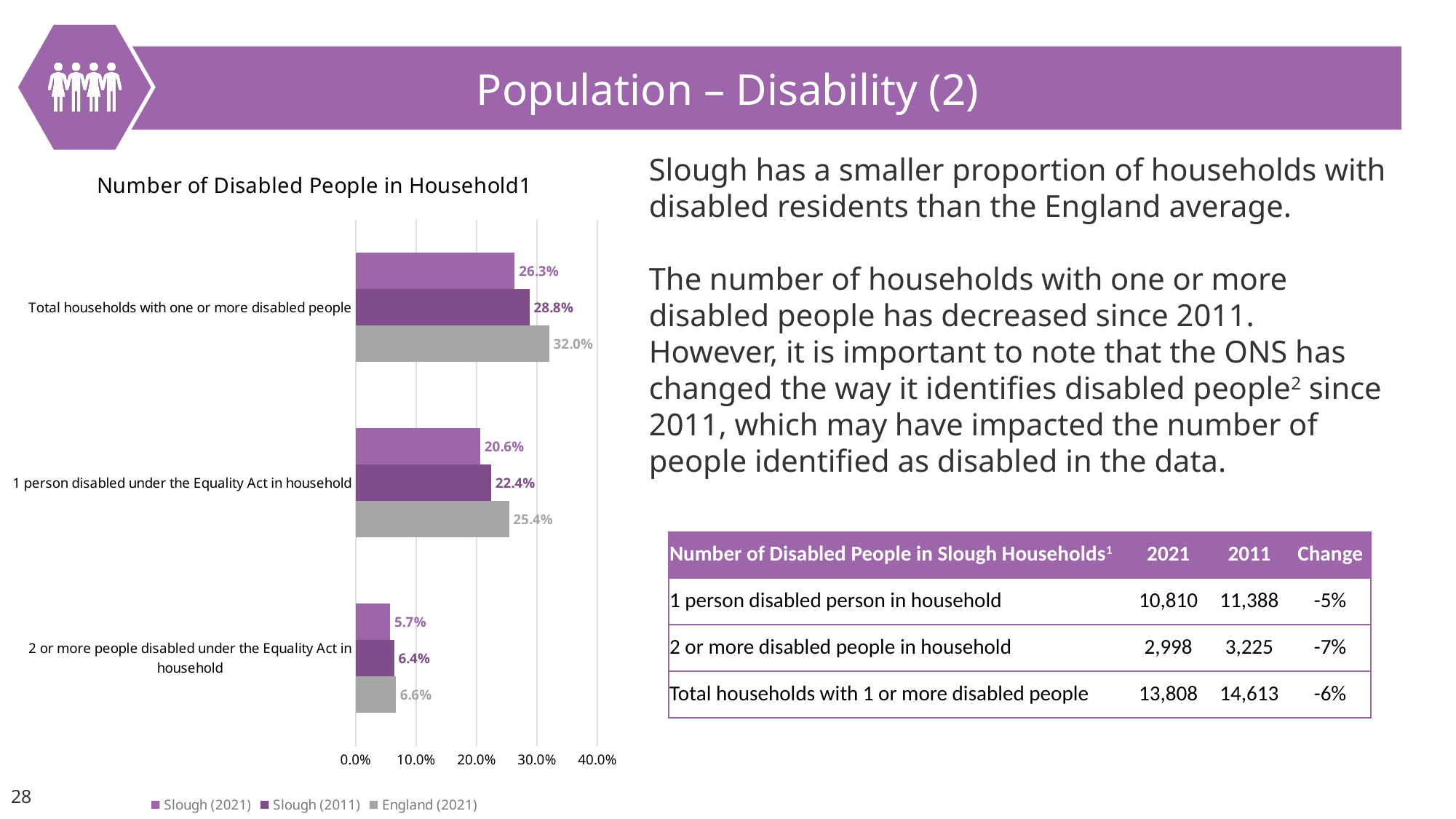
Which category has the lowest Slough (2021) value? 2 or more people disabled under the Equality Act in household What type of chart is shown on the slide? Bar chart What is the Slough (2021) value for 'Total households with one or more disabled people'? 26.3% Which is larger for '1 person disabled under the Equality Act in household': Slough (2021) or Slough (2011)? Slough (2011) Is the England (2021) value for 'Total households with one or more disabled people' greater or less than 30.0%? greater Which series has the highest value for 'Total households with one or more disabled people'? England (2021) How many series does the chart legend list? 3 What is the difference between the Slough (2011) and Slough (2021) values for '1 person disabled under the Equality Act in household'? 1.8% What is the difference between the England (2021) and Slough (2021) values for 'Total households with one or more disabled people'? 5.7% How many categories are shown on the chart? 3 What is the Slough (2011) value for '2 or more people disabled under the Equality Act in household'? 6.4% What is the England (2021) value for '1 person disabled under the Equality Act in household'? 25.4%